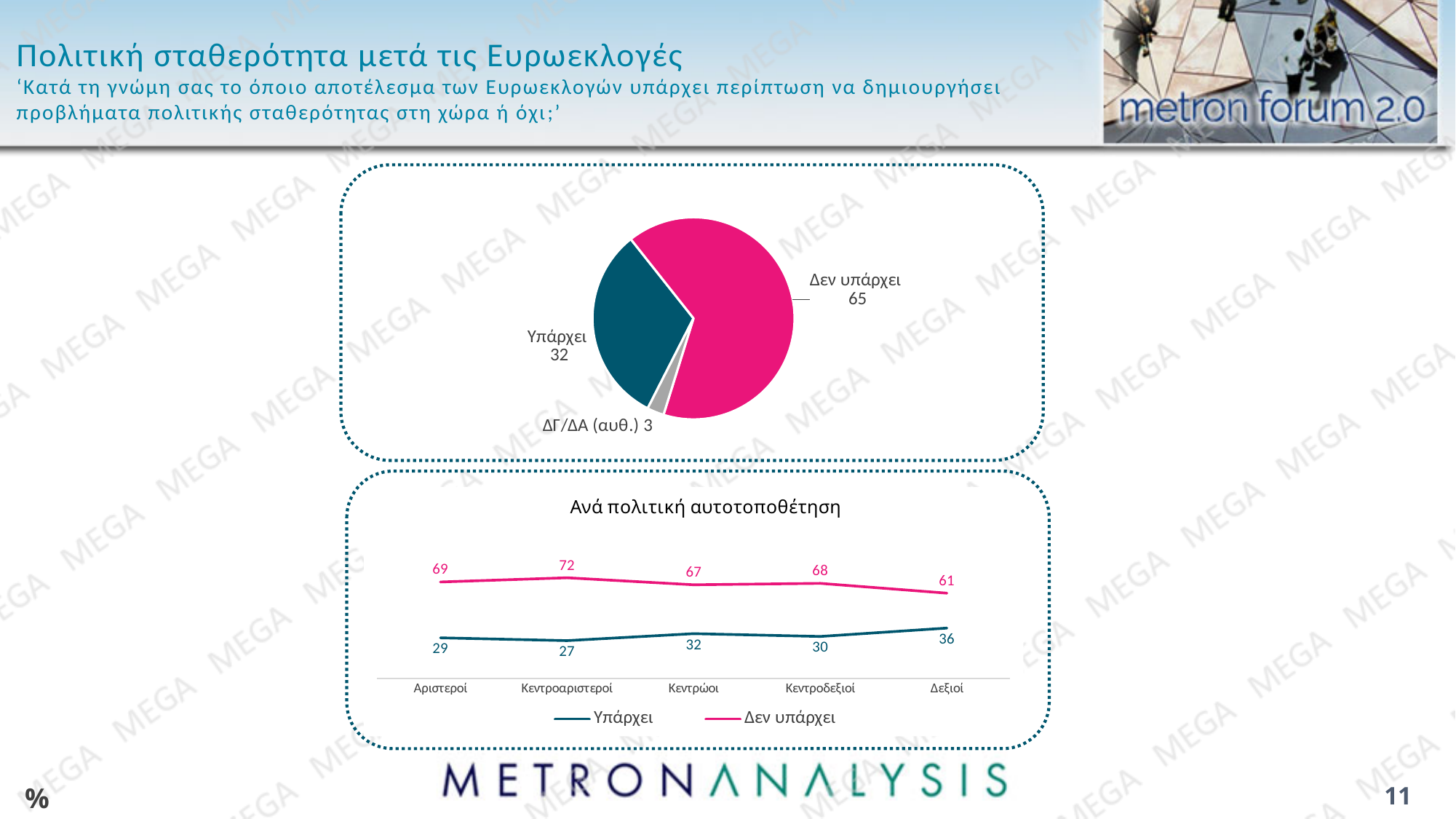
What kind of chart is 'Ανά πολιτική αυτοτοποθέτηση'? Line chart In the pie chart at the top of the slide, which slice is the smallest? ΔΓ/ΔΑ (αυθ.) In the pie chart at the top of the slide, what is the value for 'Δεν υπάρχει'? 65 In the chart 'Ανά πολιτική αυτοτοποθέτηση', what is the value of 'Υπάρχει' for 'Δεξιοί'? 36 In the pie chart at the top of the slide, what is the value for 'Υπάρχει'? 32 In the pie chart at the top of the slide, what is the difference between 'Δεν υπάρχει' and 'Υπάρχει'? 33 In the chart 'Ανά πολιτική αυτοτοποθέτηση', which category has the lowest value for 'Υπάρχει'? Κεντροαριστεροί In the chart 'Ανά πολιτική αυτοτοποθέτηση', what is the difference between 'Δεν υπάρχει' and 'Υπάρχει' for 'Δεξιοί'? 25 In the pie chart at the top of the slide, how many slices are there? 3 In the chart 'Ανά πολιτική αυτοτοποθέτηση', which category has the highest value for 'Δεν υπάρχει'? Κεντροαριστεροί In the chart 'Ανά πολιτική αυτοτοποθέτηση', what is the value of 'Δεν υπάρχει' for 'Κεντροαριστεροί'? 72 In the chart 'Ανά πολιτική αυτοτοποθέτηση', how many series does the legend list? 2